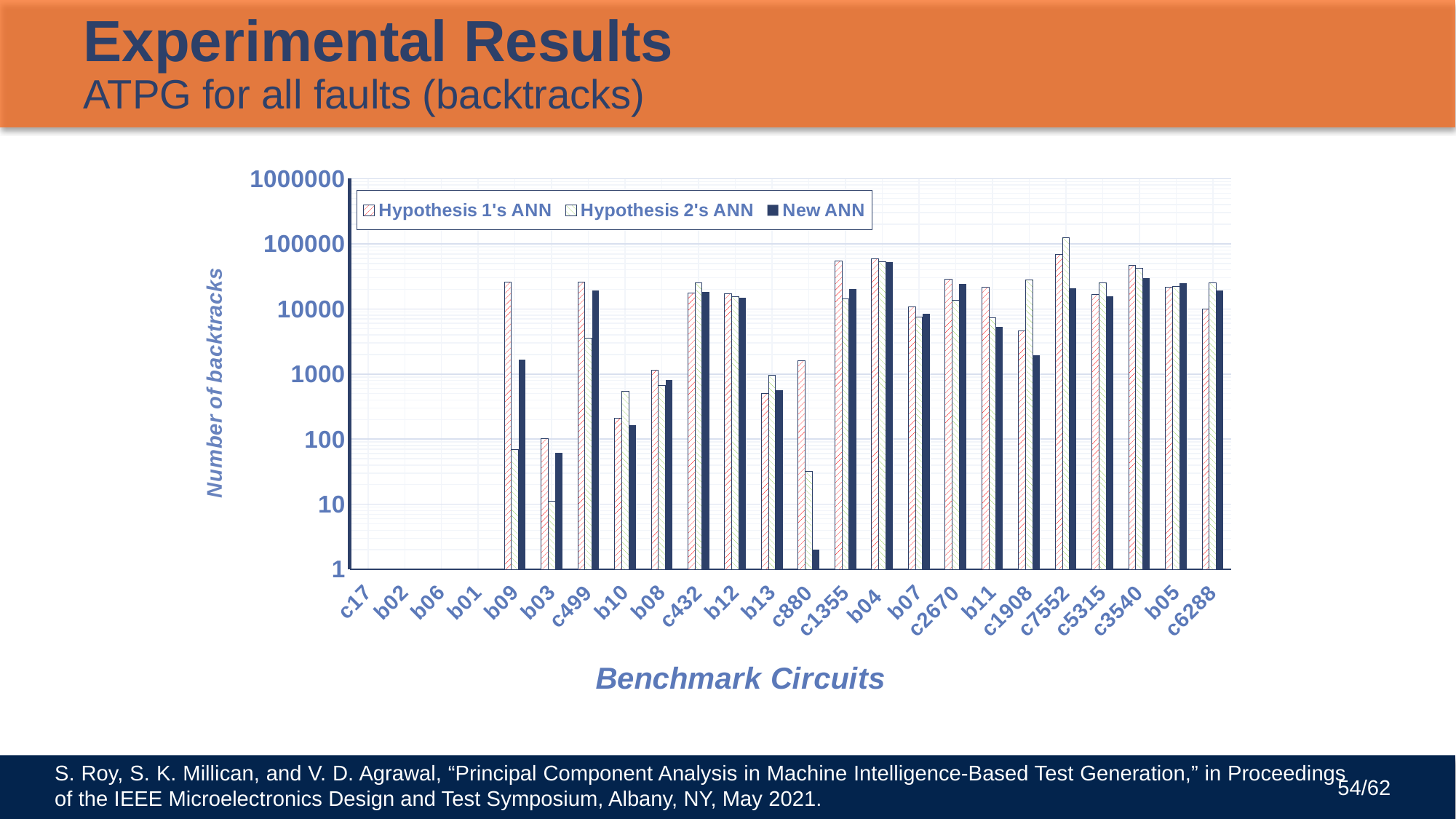
What is the title of the y axis? Number of backtracks Is the New ANN value for c880 greater or less than 10? less What kind of chart is shown on the slide? bar chart For b09, which is larger: Hypothesis 1's ANN or New ANN? Hypothesis 1's ANN Is the Hypothesis 2's ANN value for c7552 greater or less than 100000? greater Is the Hypothesis 1's ANN value for b09 greater or less than 10000? greater Which benchmark circuit has the highest Hypothesis 2's ANN value? c7552 For c7552, which is larger: Hypothesis 1's ANN or Hypothesis 2's ANN? Hypothesis 2's ANN How many series does the legend list? 3 How many benchmark circuits are listed on the x axis? 24 What is the title of the x axis? Benchmark Circuits